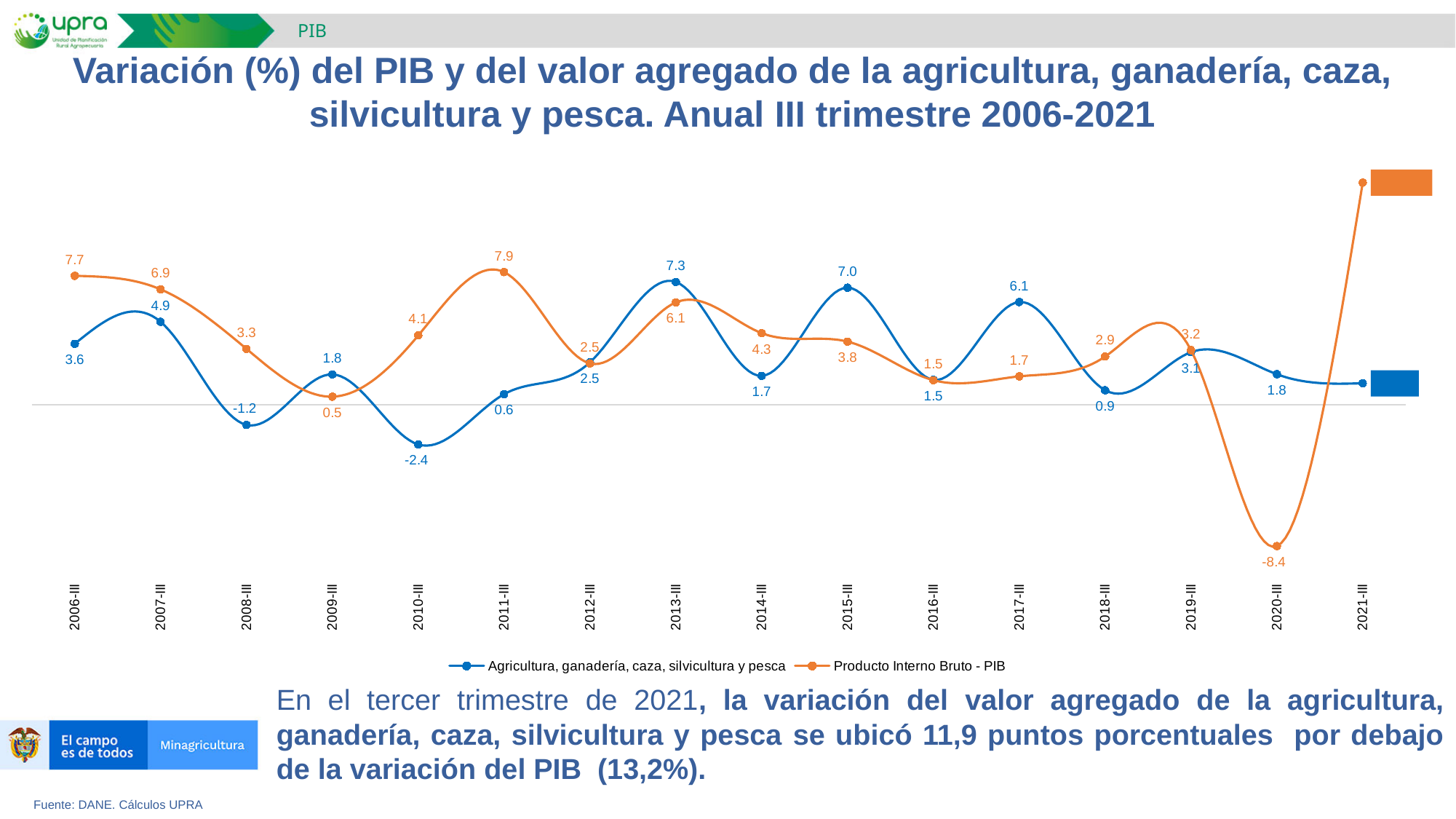
Which series is drawn in orange? Producto Interno Bruto - PIB What is the value of Agricultura, ganadería, caza, silvicultura y pesca for 2017-III? 6.1 Which series has the larger value in 2011-III, Agricultura, ganadería, caza, silvicultura y pesca or Producto Interno Bruto - PIB? Producto Interno Bruto - PIB In which period does Producto Interno Bruto - PIB reach its lowest value? 2020-III What is the difference between Agricultura, ganadería, caza, silvicultura y pesca and Producto Interno Bruto - PIB in 2013-III? 1.2 How many series does the legend list? 2 What kind of chart is shown on the slide? line chart How many periods are plotted along the x axis? 16 What is the value of Agricultura, ganadería, caza, silvicultura y pesca for 2010-III? -2.4 What is the value of Producto Interno Bruto - PIB for 2020-III? -8.4 What is the value of Producto Interno Bruto - PIB for 2006-III? 7.7 In which period does Agricultura, ganadería, caza, silvicultura y pesca reach its lowest value? 2010-III